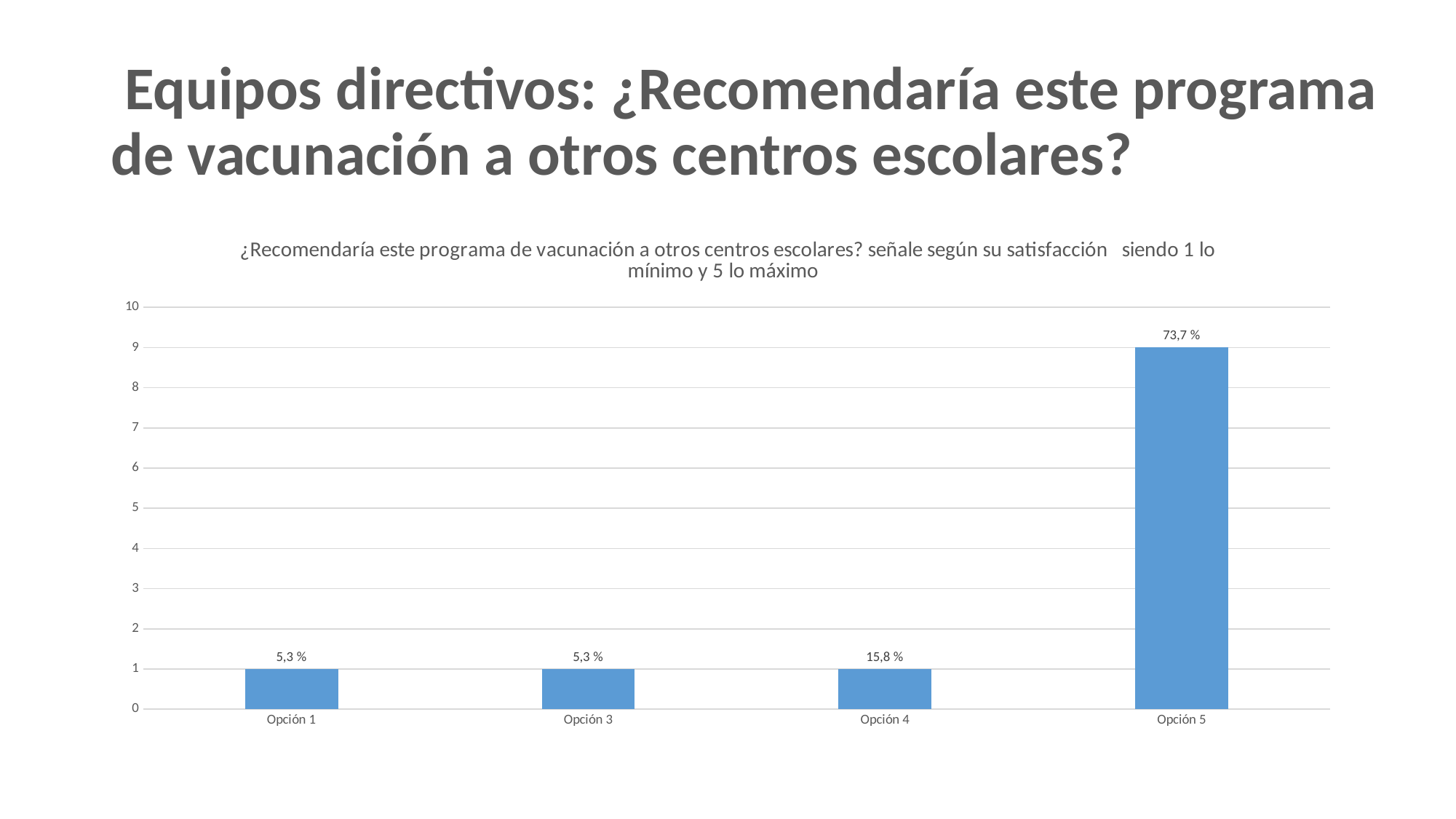
Which category has the highest bar? Opción 5 What is the data label shown for Opción 3? 5,3 % What is the data label shown for Opción 1? 5,3 % What is the data label shown for Opción 5? 73,7 % Which is larger, the value for Opción 5 or the value for Opción 4? Opción 5 What kind of chart is shown on the slide? Bar chart What is the maximum value shown on the vertical axis? 10 Is the bar for Opción 1 greater or less than 5 on the vertical axis? less What is the data label shown for Opción 4? 15,8 % What is the difference between the data labels for Opción 5 and Opción 4? 57,9 % Is the bar for Opción 5 greater or less than 5 on the vertical axis? greater How many categories are shown on the x axis? 4